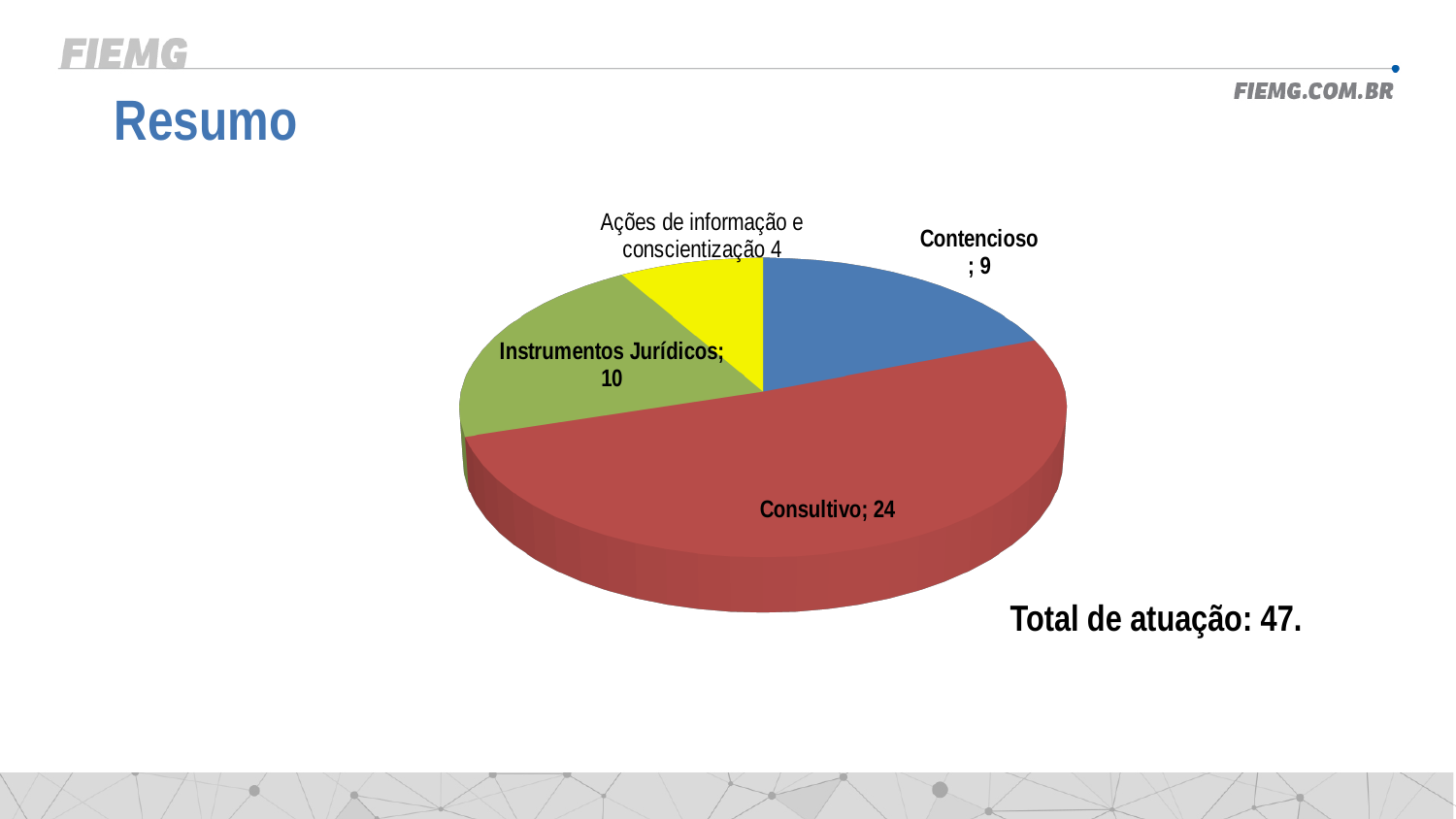
Which category has the smallest slice of the pie? Ações de informação e conscientização What total is stated on the slide next to the chart? 47 What kind of chart is shown on the slide? pie chart What is the value for Consultivo? 24 How many categories does the pie chart have? 4 What is the value for Instrumentos Jurídicos? 10 Which is larger, the value for Instrumentos Jurídicos or the value for Contencioso? Instrumentos Jurídicos What is the difference between the values for Instrumentos Jurídicos and Ações de informação e conscientização? 6 What is the difference between the values for Consultivo and Contencioso? 15 What is the value for Ações de informação e conscientização? 4 What is the value for Contencioso? 9 Which category has the largest slice of the pie? Consultivo